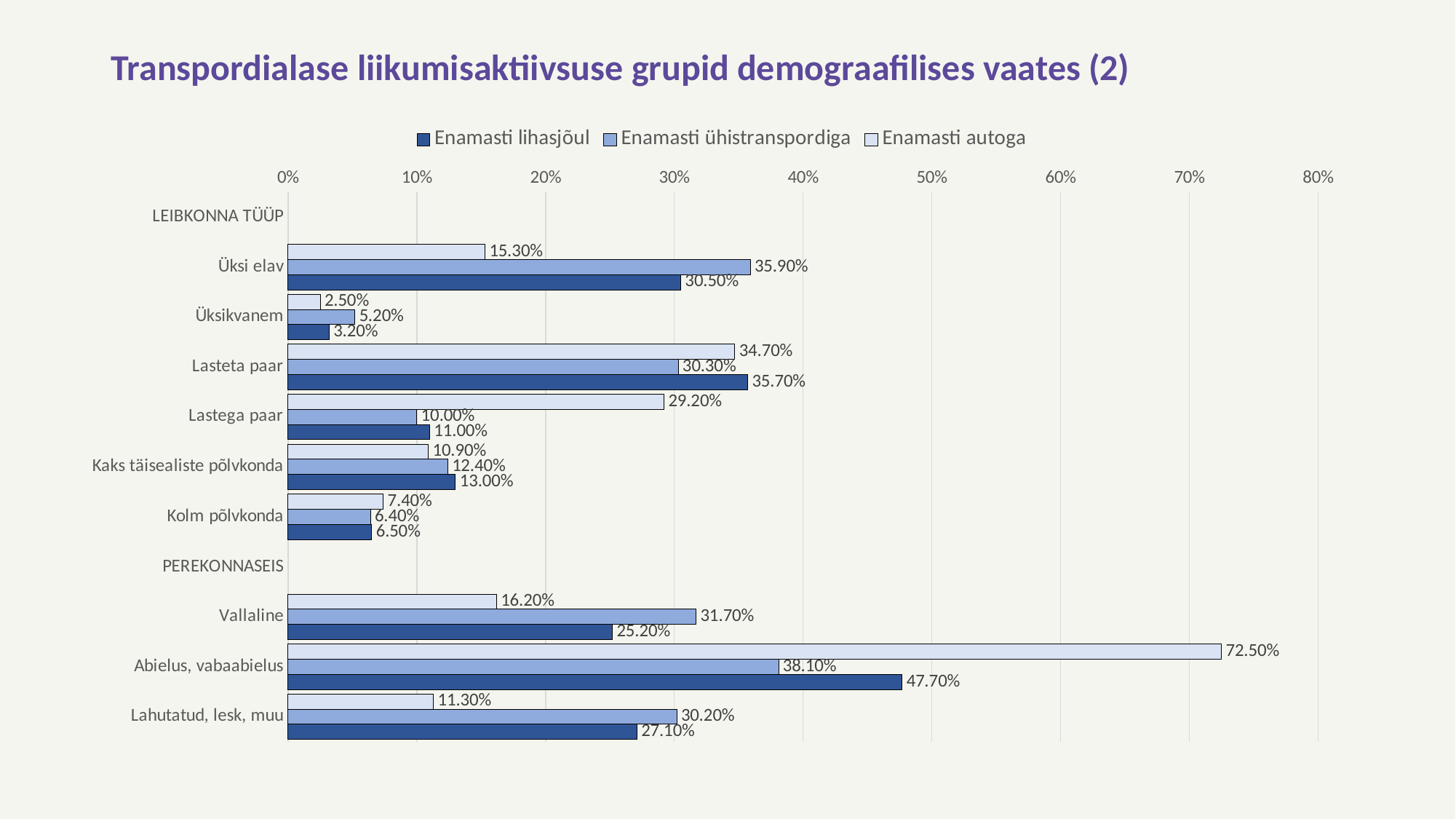
What is the value for "Enamasti autoga" in the "Abielus, vabaabielus" category? 72.50% Is the value for "Enamasti autoga" in "Lasteta paar" greater or less than 30%? greater How many series does the legend list? 3 Which category has the highest value for "Enamasti autoga"? Abielus, vabaabielus What is the difference between the "Enamasti autoga" and "Enamasti lihasjõul" values for "Abielus, vabaabielus"? 24.80% What is the value for "Enamasti lihasjõul" in the "Üksi elav" category? 30.50% For "Vallaline", which is larger: "Enamasti ühistranspordiga" or "Enamasti lihasjõul"? Enamasti ühistranspordiga What kind of chart is shown on the slide? Bar chart What is the value for "Enamasti ühistranspordiga" in the "Lastega paar" category? 10.00% Which category has the lowest value for "Enamasti ühistranspordiga"? Üksikvanem What is the title of the chart? Transpordialase liikumisaktiivsuse grupid demograafilises vaates (2) What is the difference between the "Enamasti ühistranspordiga" and "Enamasti autoga" values for "Üksi elav"? 20.60%